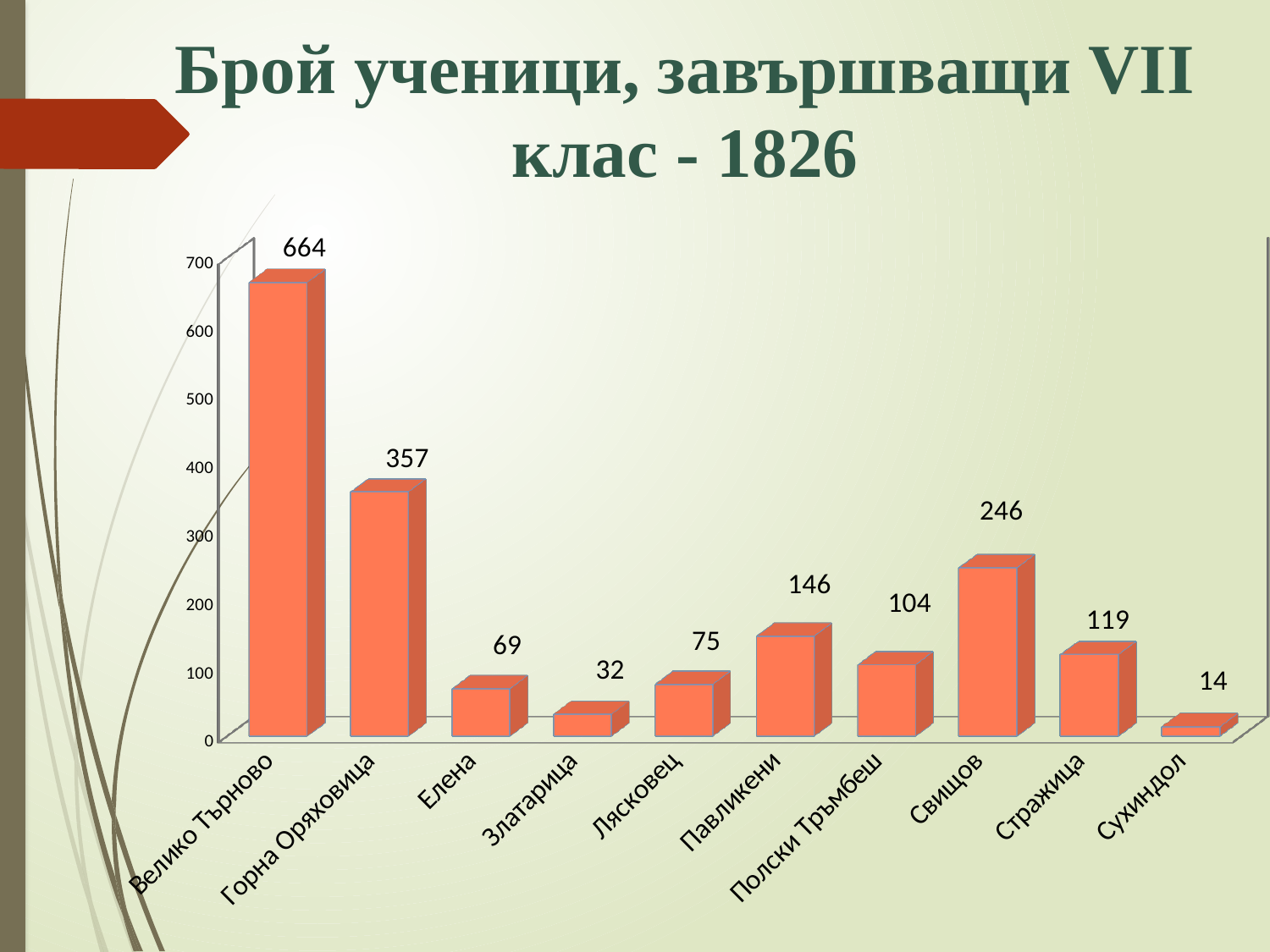
Which category has the lowest value? Сухиндол What is the value for Полски Тръмбеш? 104 Is the value for Горна Оряховица greater or less than 300? greater What is the title of the chart? Брой ученици, завършващи VII клас - 1826 What is the value for Велико Търново? 664 Which category has the highest value? Велико Търново What kind of chart is shown on the slide? bar chart Which is larger, the value for Павликени or the value for Стражица? Павликени What is the difference between the values for Свищов and Стражица? 127 What is the difference between the values for Велико Търново and Горна Оряховица? 307 How many categories are shown on the x axis? 10 What is the value for Свищов? 246